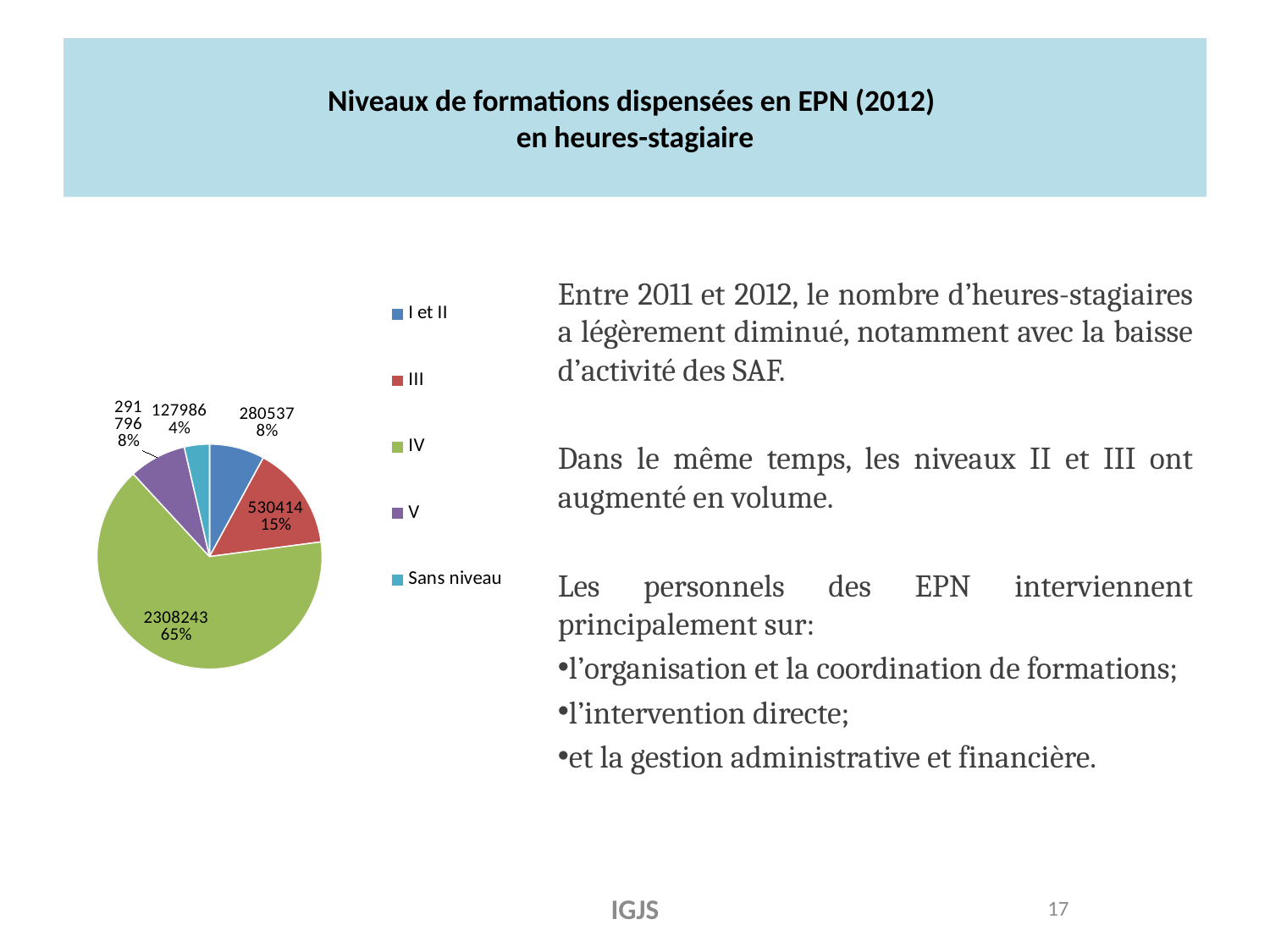
What is the value for IV in the pie chart? 2308243 Which is larger, the value for III or the value for V? III What share of the pie does IV represent? 65% What is the value for III in the pie chart? 530414 How many categories does the legend of the pie chart list? 5 What share of the pie does III represent? 15% Which category has the smallest slice of the pie? Sans niveau What kind of chart is shown on the slide? pie chart What is the value for I et II in the pie chart? 280537 Which category has the largest slice of the pie? IV What is the difference between the values for III and I et II? 249877 What is the value for Sans niveau in the pie chart? 127986